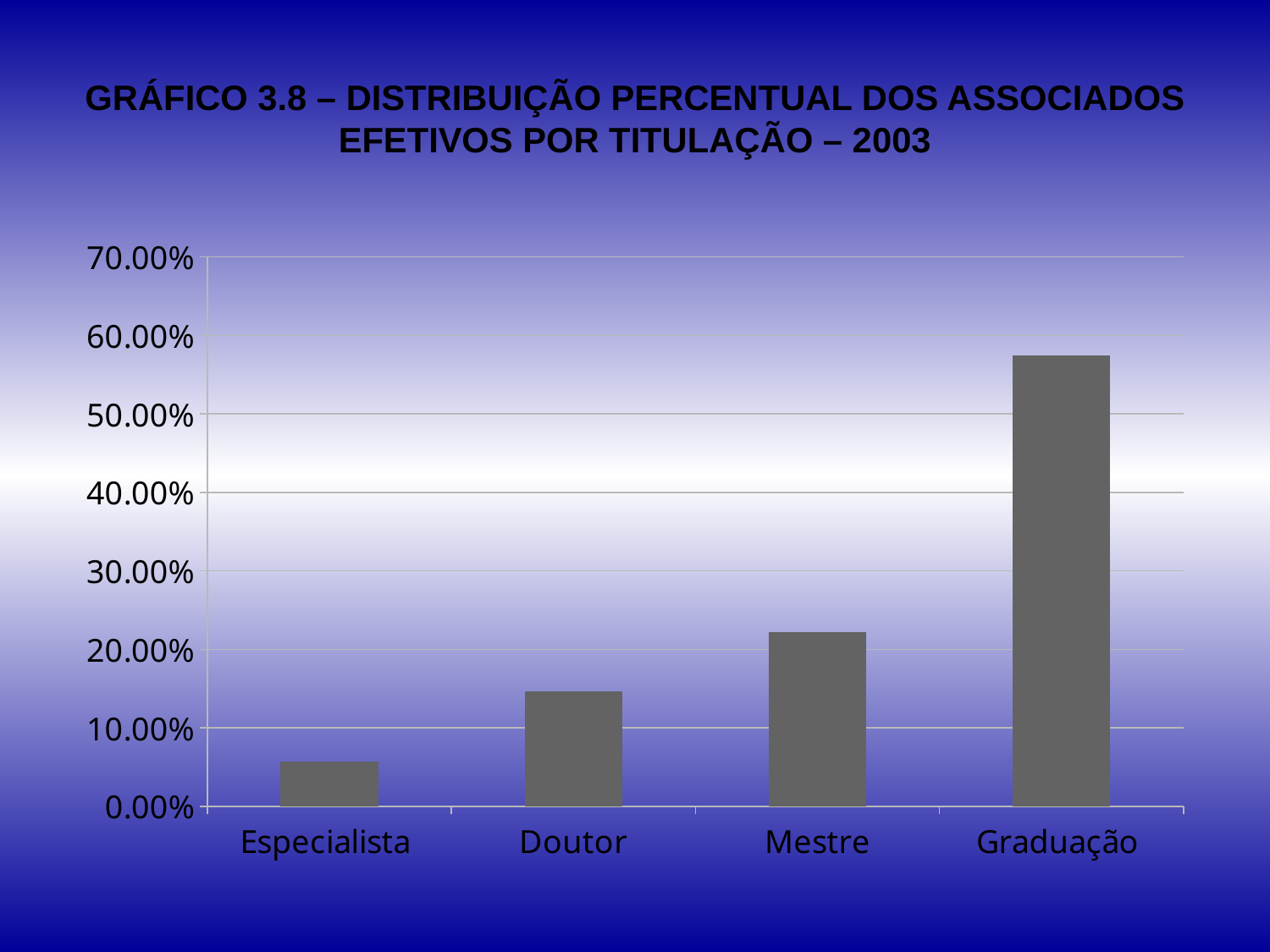
What kind of chart is shown on the slide? bar chart Which category has the lowest value in the chart? Especialista What is the highest value shown on the y axis of the chart? 70.00% Which is larger, the value for Mestre or the value for Doutor? Mestre Is the value for Graduação greater or less than 50.00%? greater Is the value for Especialista greater or less than 10.00%? less Is the value for Mestre greater or less than 20.00%? greater What is the title of the chart on the slide? GRÁFICO 3.8 – DISTRIBUIÇÃO PERCENTUAL DOS ASSOCIADOS EFETIVOS POR TITULAÇÃO – 2003 Which category has the highest value in the chart? Graduação How many categories are shown on the x axis of the chart? 4 Do the values rise or fall moving left to right along the x axis from Especialista to Graduação? rise